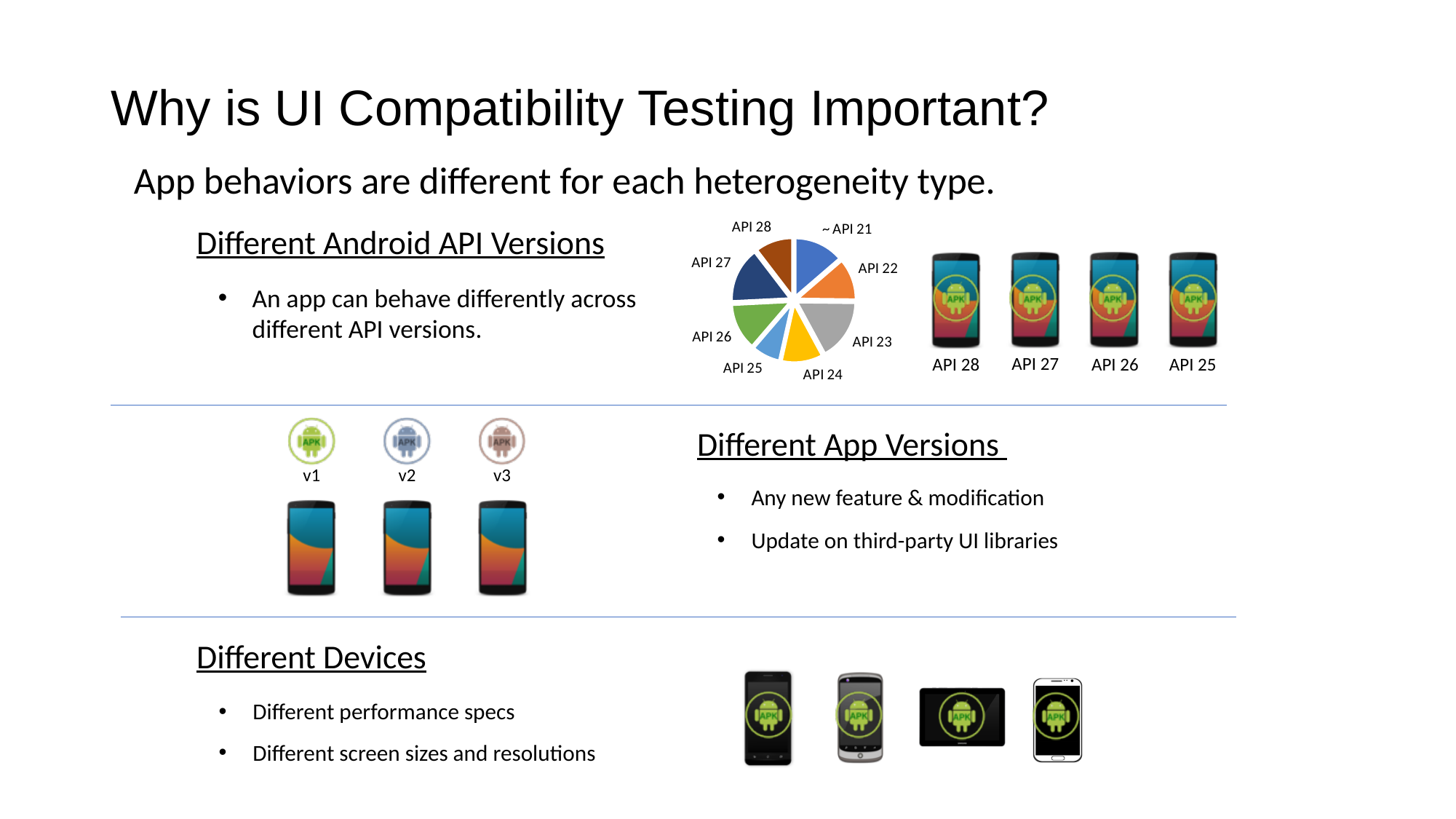
What is the highest API version labelled on the pie chart? API 28 What kind of chart is shown on the slide? pie chart What colour is the API 24 slice in the pie chart? yellow Which slice of the pie chart is labelled with a tilde (~) prefix? ~ API 21 How many slices does the pie chart have? 8 In the pie chart, which slice is larger: API 23 or API 25? API 23 Which slice of the pie chart appears smallest? API 25